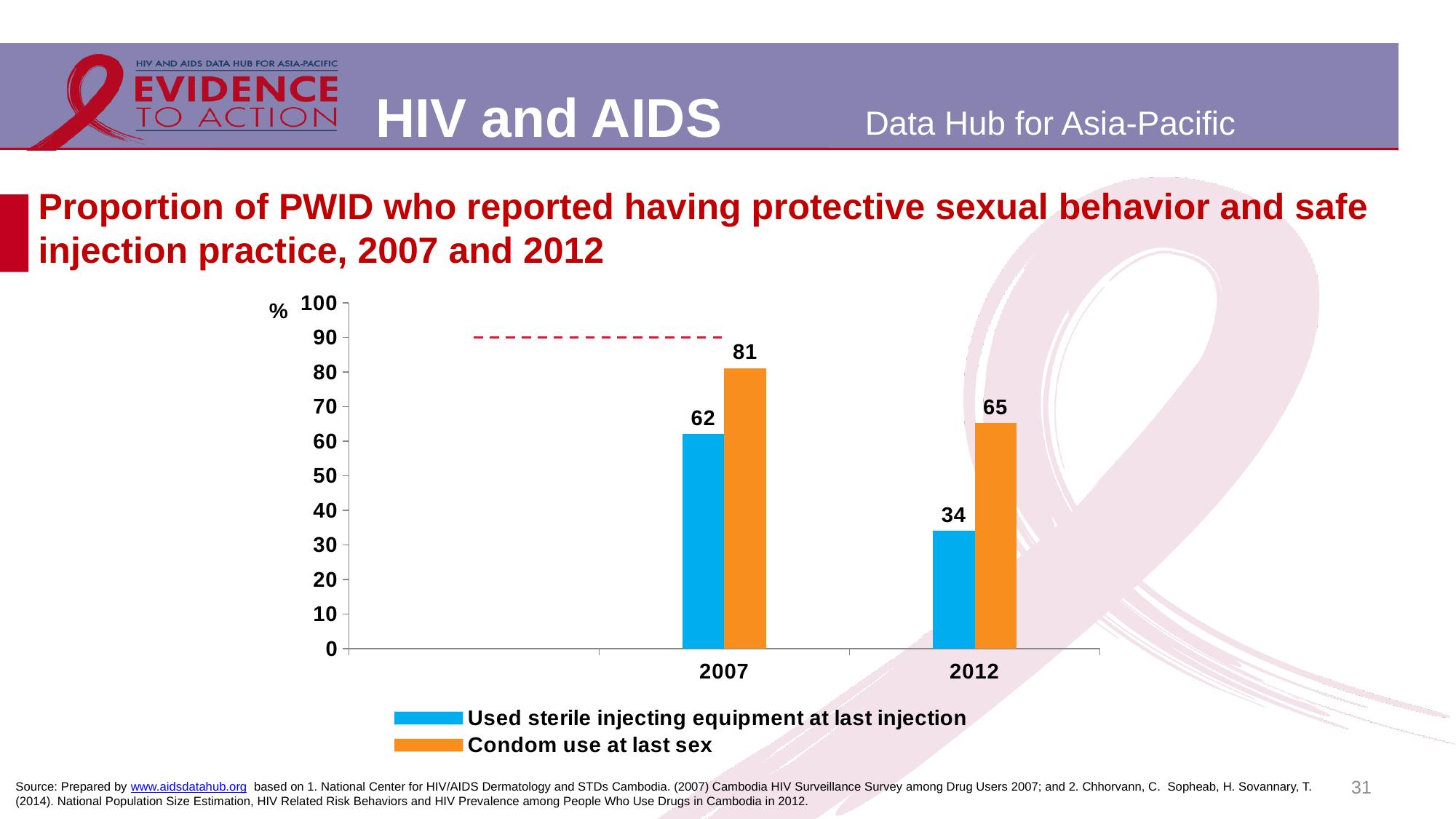
Did the proportion of PWID reporting condom use at last sex rise or fall from 2007 to 2012? Fall What kind of chart is shown on the slide? Bar chart By how many percentage points did the proportion using sterile injecting equipment at last injection fall from 2007 to 2012? 28 In 2007, which was larger: condom use at last sex or use of sterile injecting equipment at last injection? Condom use at last sex Which series has the lowest value shown on the chart? Used sterile injecting equipment at last injection Which year had the higher value for condom use at last sex? 2007 What percentage of PWID reported using sterile injecting equipment at last injection in 2007? 62 What is the difference between condom use at last sex and sterile injecting equipment use in 2012? 31 How many series does the legend list? 2 What percentage of PWID reported using sterile injecting equipment at last injection in 2012? 34 What percentage of PWID reported condom use at last sex in 2012? 65 What percentage of PWID reported condom use at last sex in 2007? 81